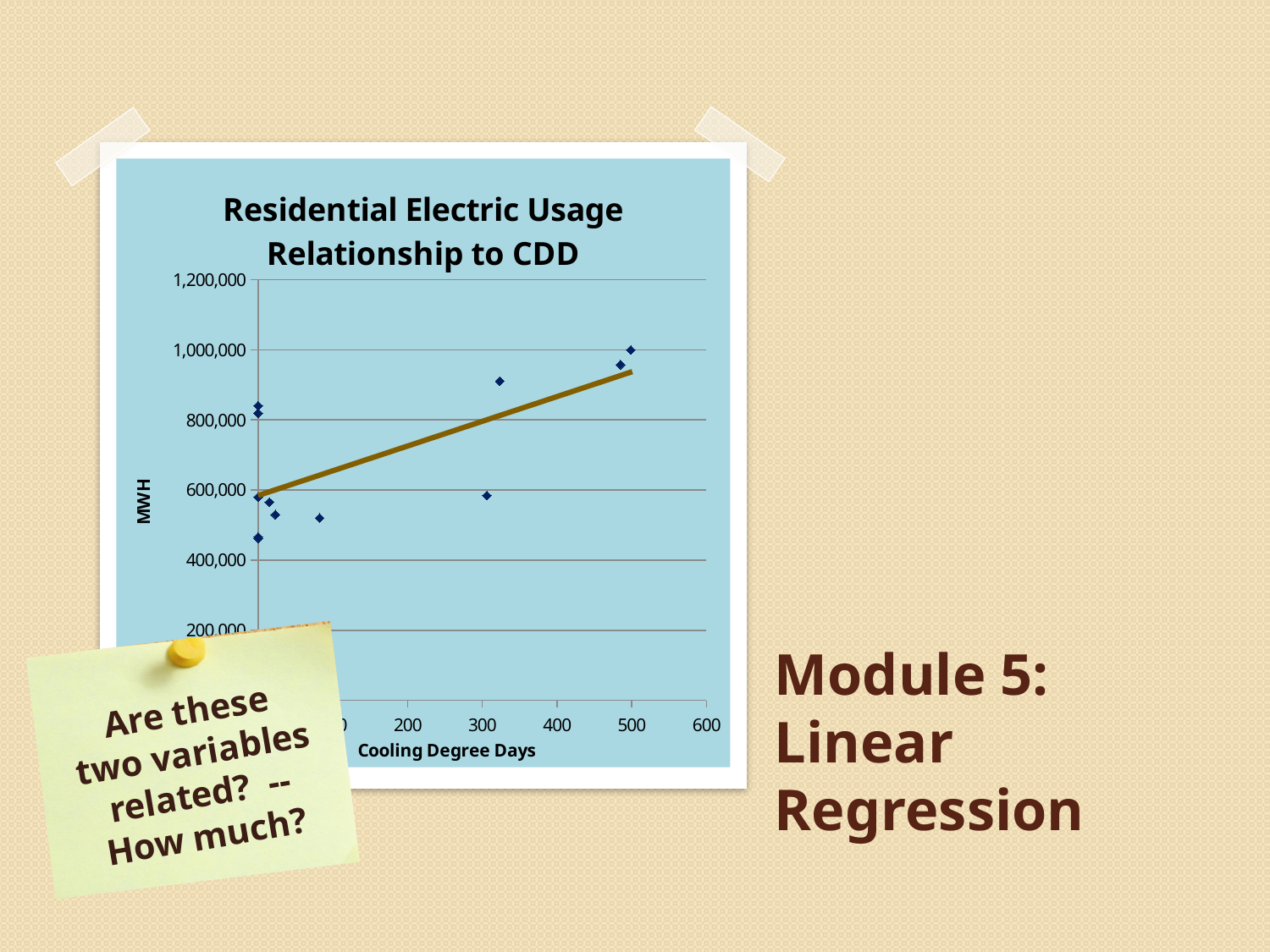
What kind of chart is shown on the slide? scatter chart Is the MWH value of the lowest plotted point greater or less than 600,000? less Is the MWH value of the point plotted at about 80 Cooling Degree Days greater or less than 800,000? less Is the MWH value of the highest plotted point greater or less than 900,000? greater What is the label on the x axis of the chart? Cooling Degree Days What is the title of the chart? Residential Electric Usage Relationship to CDD Does the trend line in the chart slope upward or downward as Cooling Degree Days increase? upward Which has the larger MWH value: the point plotted at about 500 Cooling Degree Days or the point plotted at about 80 Cooling Degree Days? the point at about 500 Cooling Degree Days Does the point with the highest MWH value lie at the high end or the low end of the Cooling Degree Days axis? high end